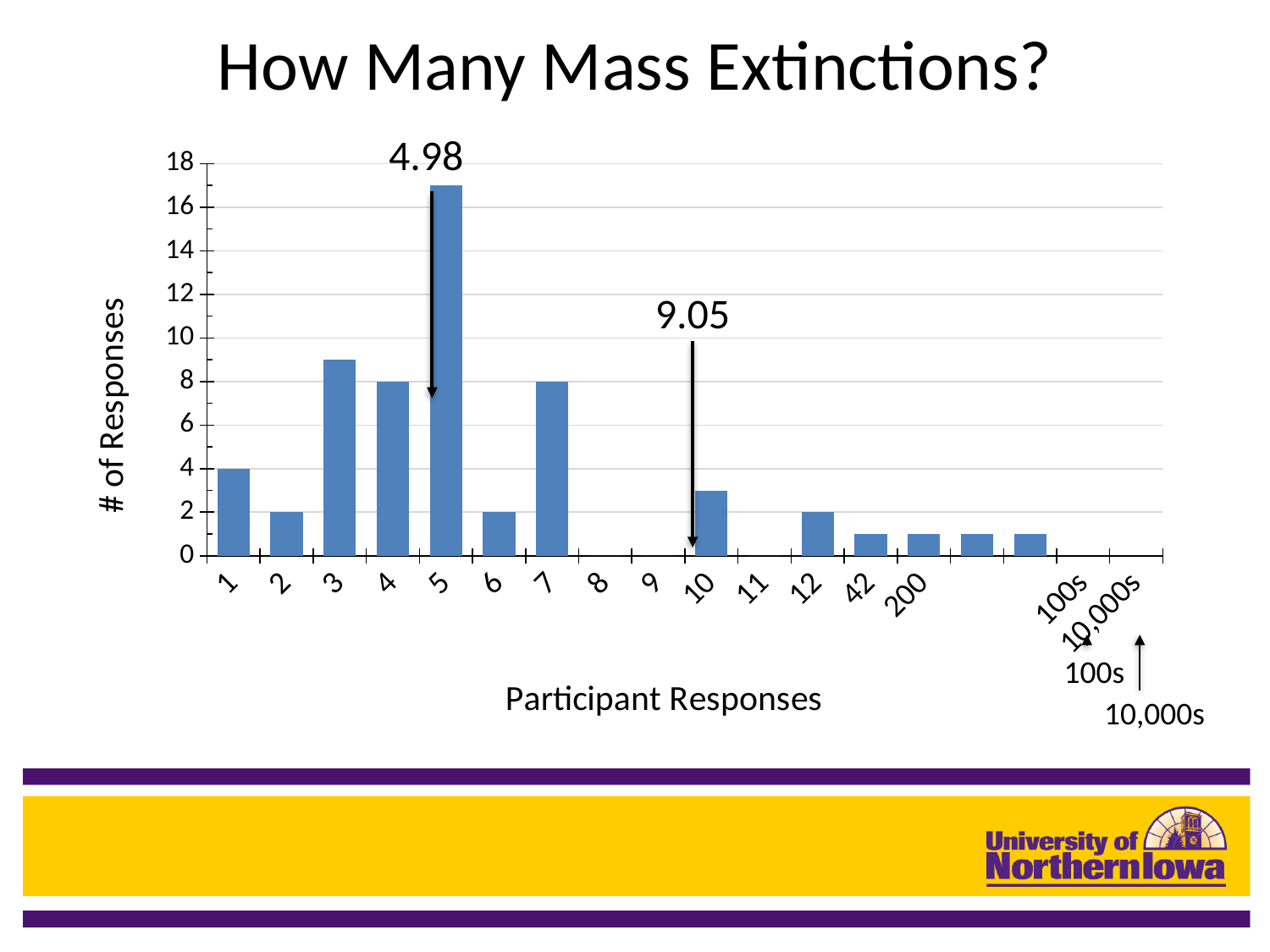
How many responses were there for the participant response of 4? 8 How many responses were there for the participant response of 1? 4 How many responses were there for the participant response of 7? 8 Which participant response received the most responses? 5 What is the difference in the number of responses between the participant response of 4 and the participant response of 2? 6 Is the number of responses for the participant response of 5 greater or less than 16? greater Which has more responses: the participant response of 5 or the participant response of 7? 5 How many responses were there for the participant response of 12? 2 Is the number of responses for the participant response of 10 greater or less than 4? less What kind of chart is shown on the slide? bar chart What two values are annotated with arrows above the chart? 4.98 and 9.05 What is the title of the y-axis? # of Responses